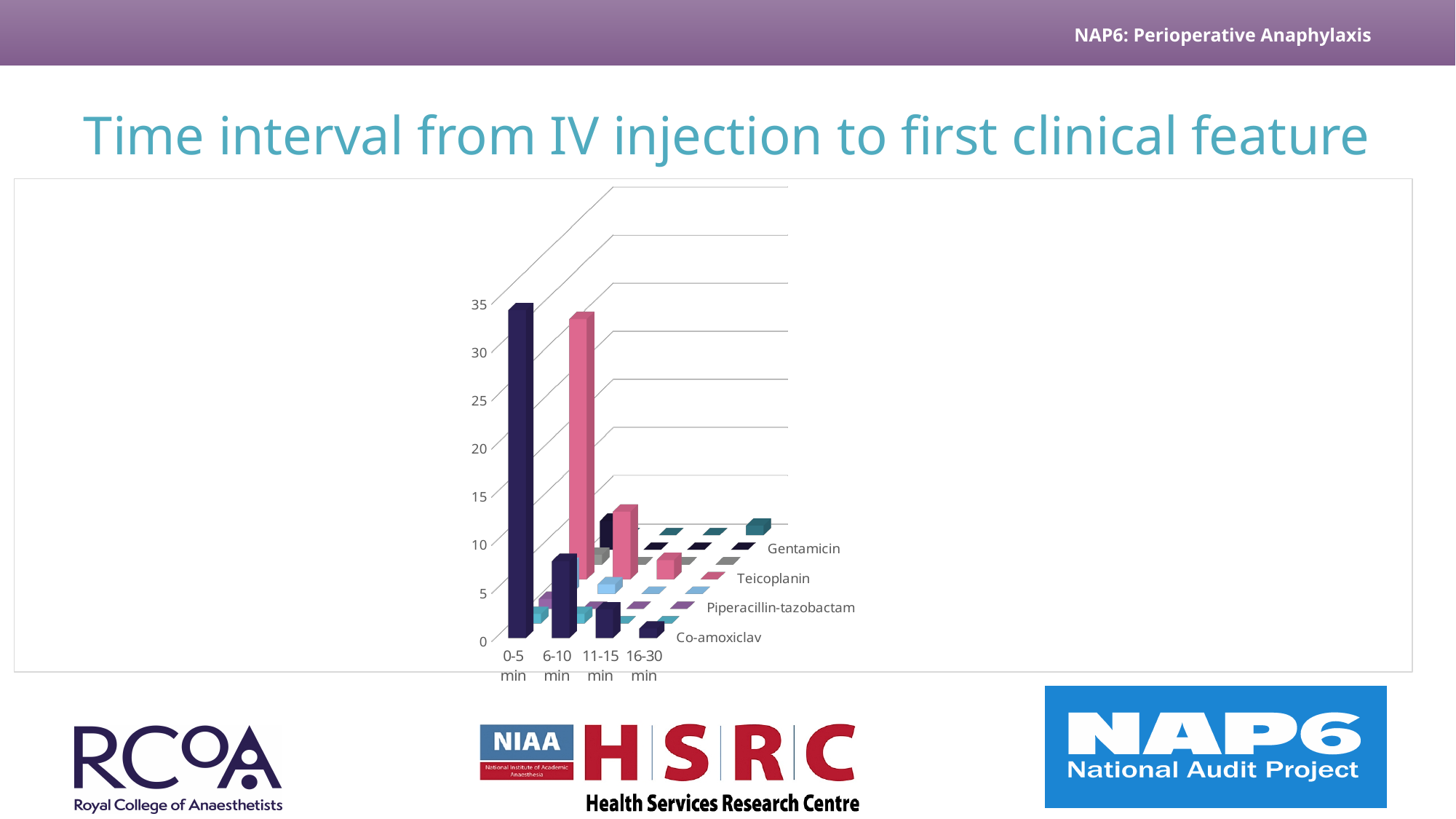
Is the value for Co-amoxiclav at 16-30 min greater or less than 5? less What kind of chart is shown on the slide? bar chart Do the Co-amoxiclav values rise or fall from 0-5 min to 16-30 min? fall Which time interval has the highest value for Teicoplanin? 0-5 min Which time interval has the highest value for Co-amoxiclav? 0-5 min How many time interval categories are shown on the x axis? 4 Is the value for Co-amoxiclav at 6-10 min greater or less than 10? less Which time interval has the lowest value for Co-amoxiclav? 16-30 min Is the value for Co-amoxiclav at 0-5 min greater or less than 30? greater What is the title of the chart on the slide? Time interval from IV injection to first clinical feature For Co-amoxiclav, which is larger: the value at 0-5 min or at 6-10 min? 0-5 min What colour are the Teicoplanin bars? pink